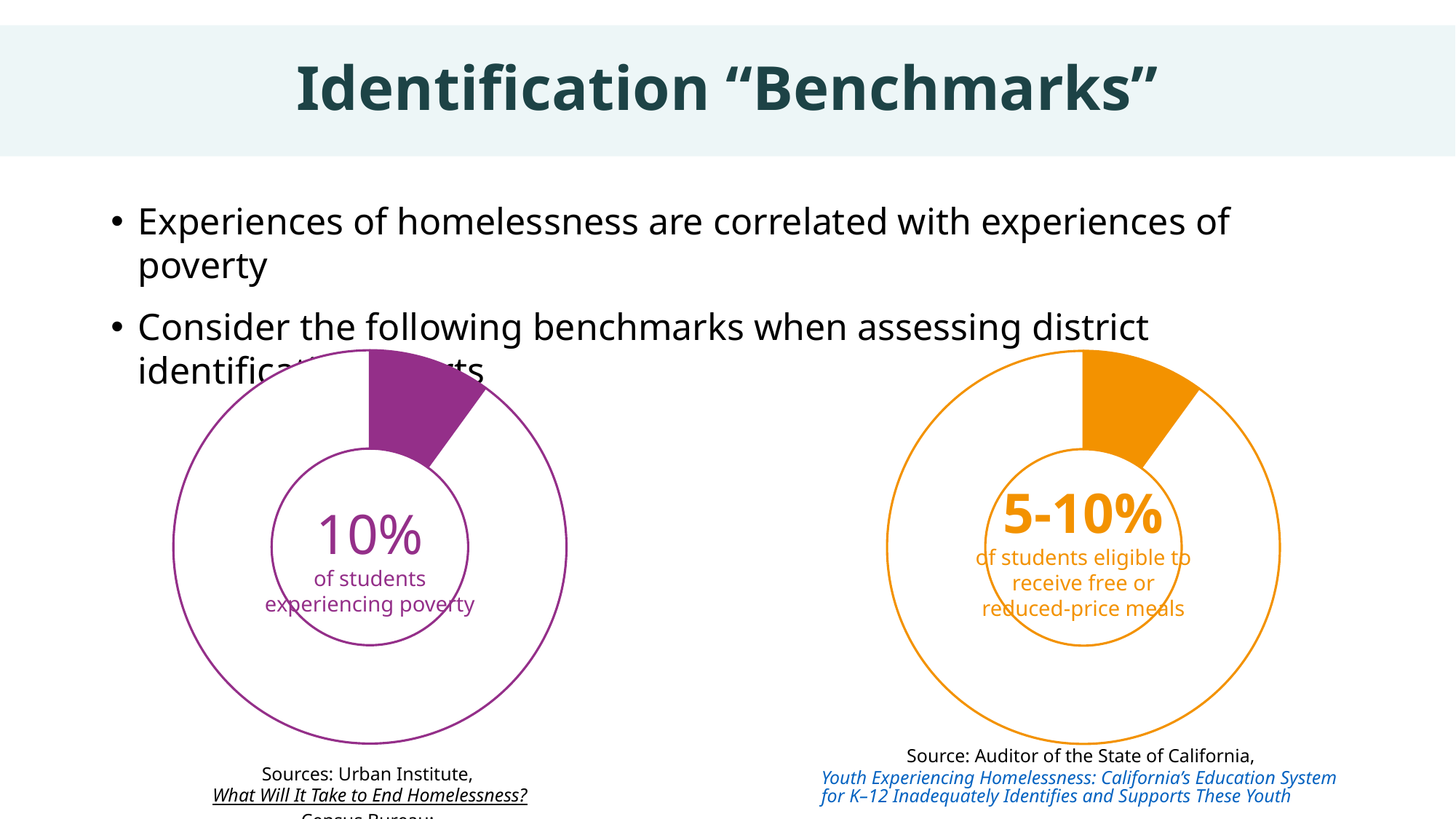
In the left chart, what percentage of students is shown as experiencing poverty? 10% In the right chart, what percentage of students is shown as eligible to receive free or reduced-price meals? 5-10% How many donut charts are shown on the slide? 2 In the left chart, is the filled slice greater or less than 50% of the ring? less What is the source cited below the right chart? Auditor of the State of California What group of students does the left chart's 10% figure refer to? Students experiencing poverty What colour is the filled slice in the right chart? Orange What colour is the filled slice in the left chart? Purple What kind of chart is the orange chart on the right of the slide? Donut chart In the right chart, is the filled slice greater or less than 25% of the ring? less What kind of chart is the purple chart on the left of the slide? Donut chart